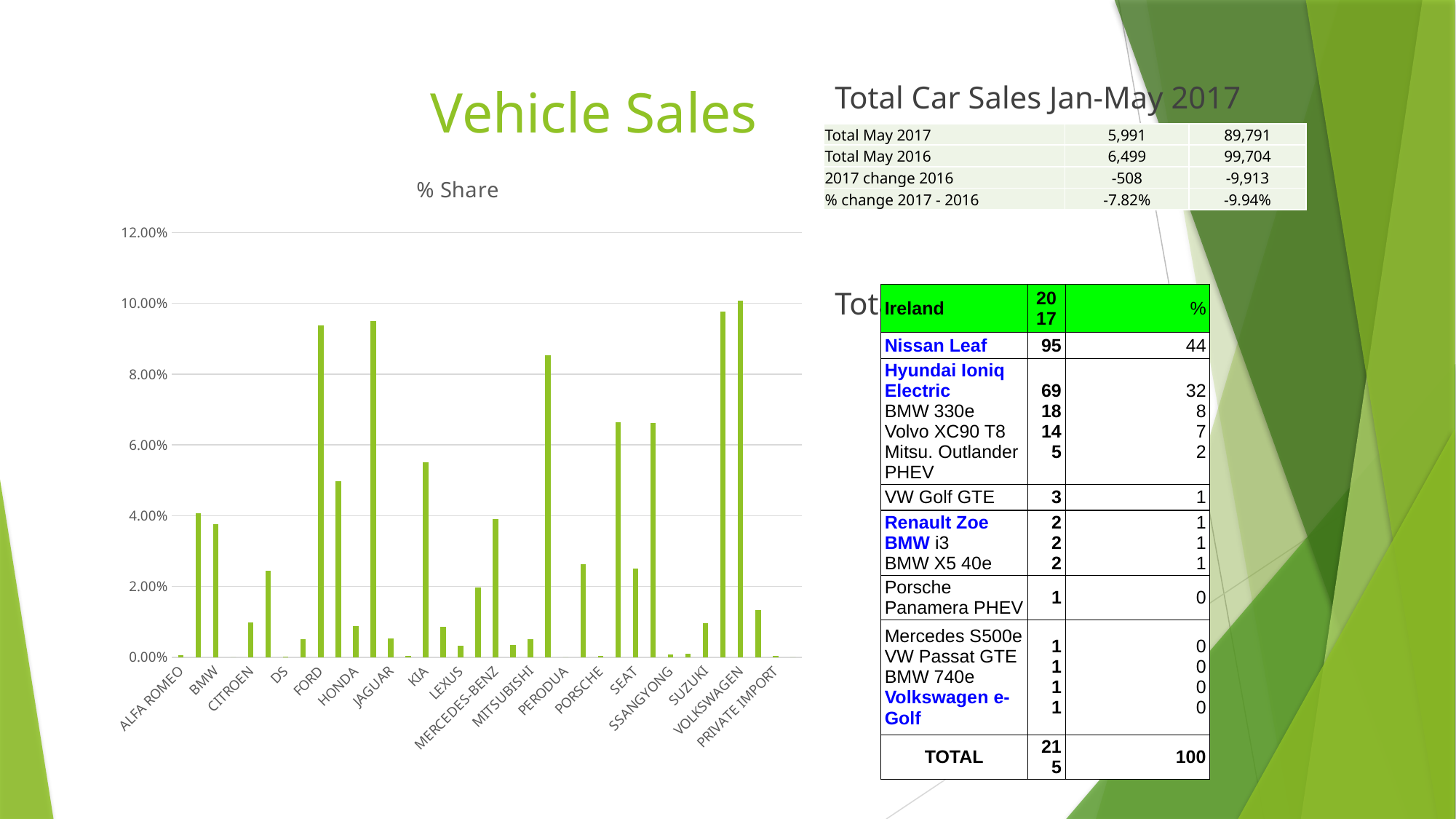
What kind of chart is shown on the slide? bar chart Is the value for FORD greater or less than 8.00%? greater Is the value for MERCEDES-BENZ greater or less than 2.00%? greater Is the value for KIA greater or less than 4.00%? greater Which has the larger share, BMW or HONDA? BMW Among the labelled brands, which has the highest share? VOLKSWAGEN Which has the larger share, FORD or KIA? FORD What is the title of the chart? % Share Which has the larger share, VOLKSWAGEN or SEAT? VOLKSWAGEN